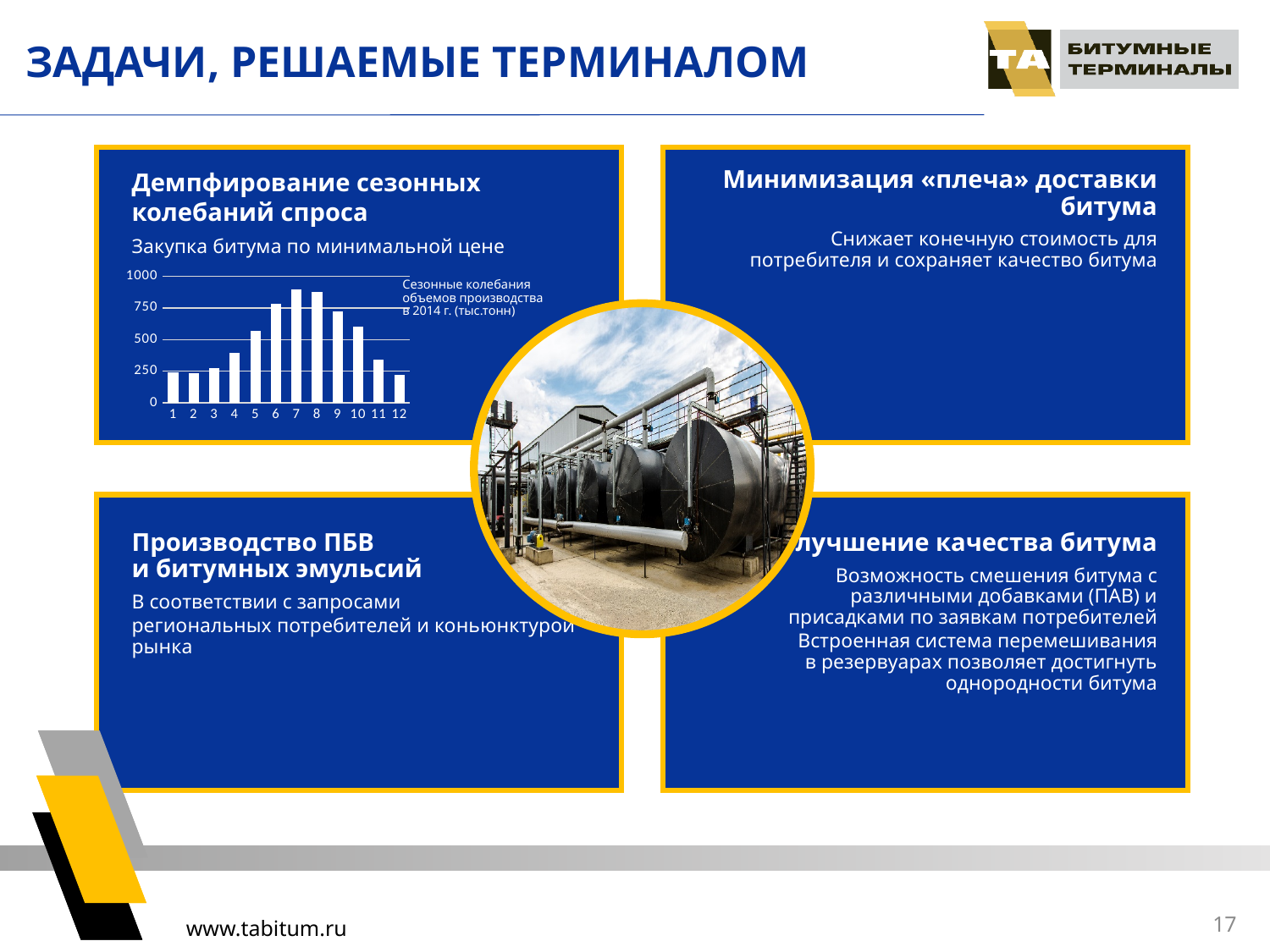
What kind of chart is shown on the slide? bar chart How many categories (months) are plotted on the x axis of the chart? 12 Is the value for month 7 greater or less than 750? greater Is the value for month 9 greater or less than 500? greater Which is larger, the value for month 4 or the value for month 11? month 4 Which is larger, the value for month 7 or the value for month 1? month 7 Do the values rise or fall from month 8 to month 12? fall What is the highest tick value shown on the chart's vertical axis? 1000 Do the values rise or fall from month 1 to month 7? rise Is the value for month 4 greater or less than 500? less